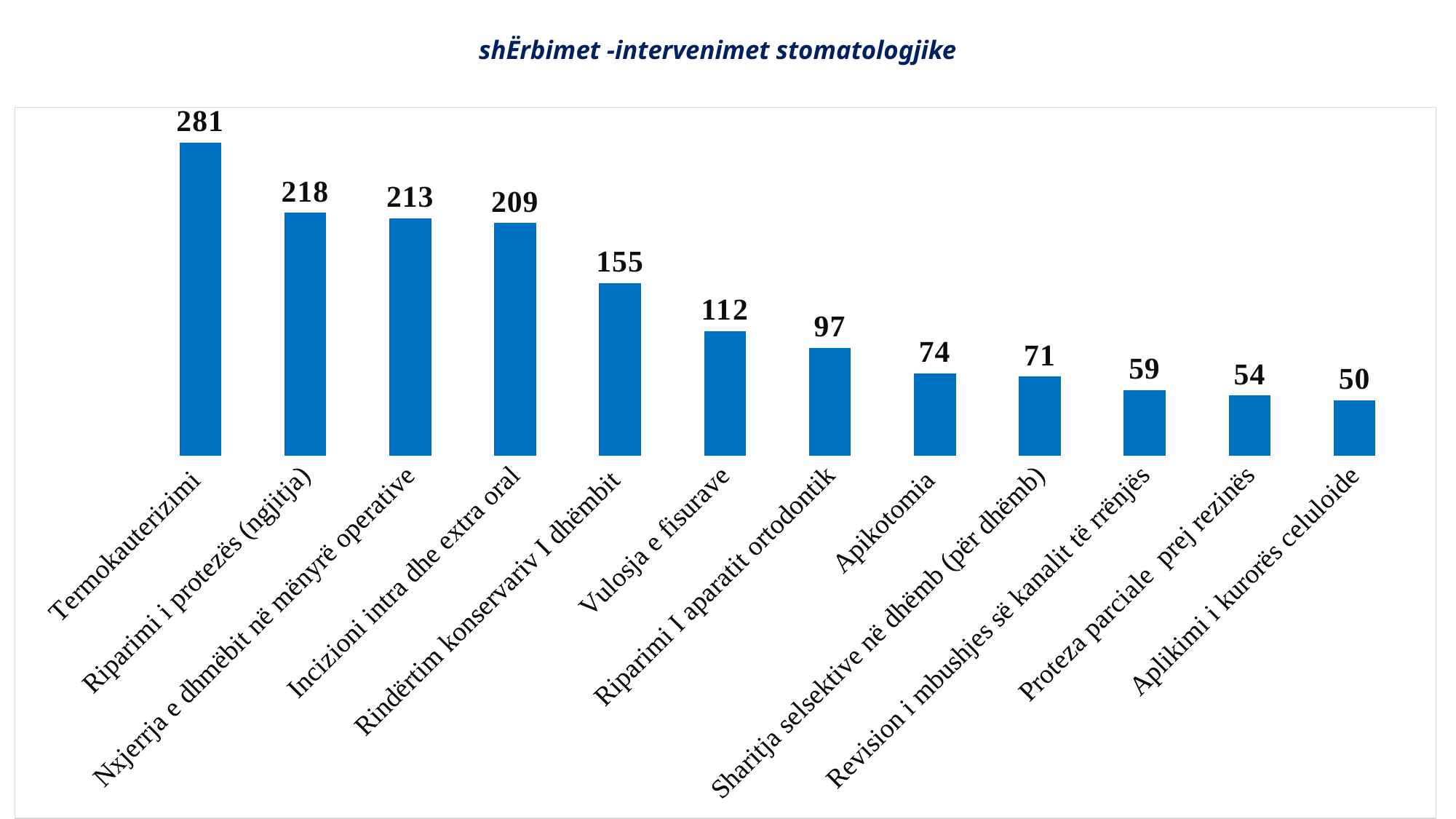
What is the difference between the values for Termokauterizimi and Riparimi i protezës (ngjitja)? 63 Which category has the highest value? Termokauterizimi How many categories are shown in the chart? 12 What is the value for Proteza parciale prej rezinës? 54 What is the value for Termokauterizimi? 281 What is the value for Apikotomia? 74 What is the title of the chart? shËrbimet -intervenimet stomatologjike What is the difference between the values for Rindërtim konservariv I dhëmbit and Vulosja e fisurave? 43 What is the value for Vulosja e fisurave? 112 Which category has the lowest value? Aplikimi i kurorës celuloide What kind of chart is shown on the slide? Bar chart Which is larger, the value for Incizioni intra dhe extra oral or the value for Riparimi I aparatit ortodontik? Incizioni intra dhe extra oral